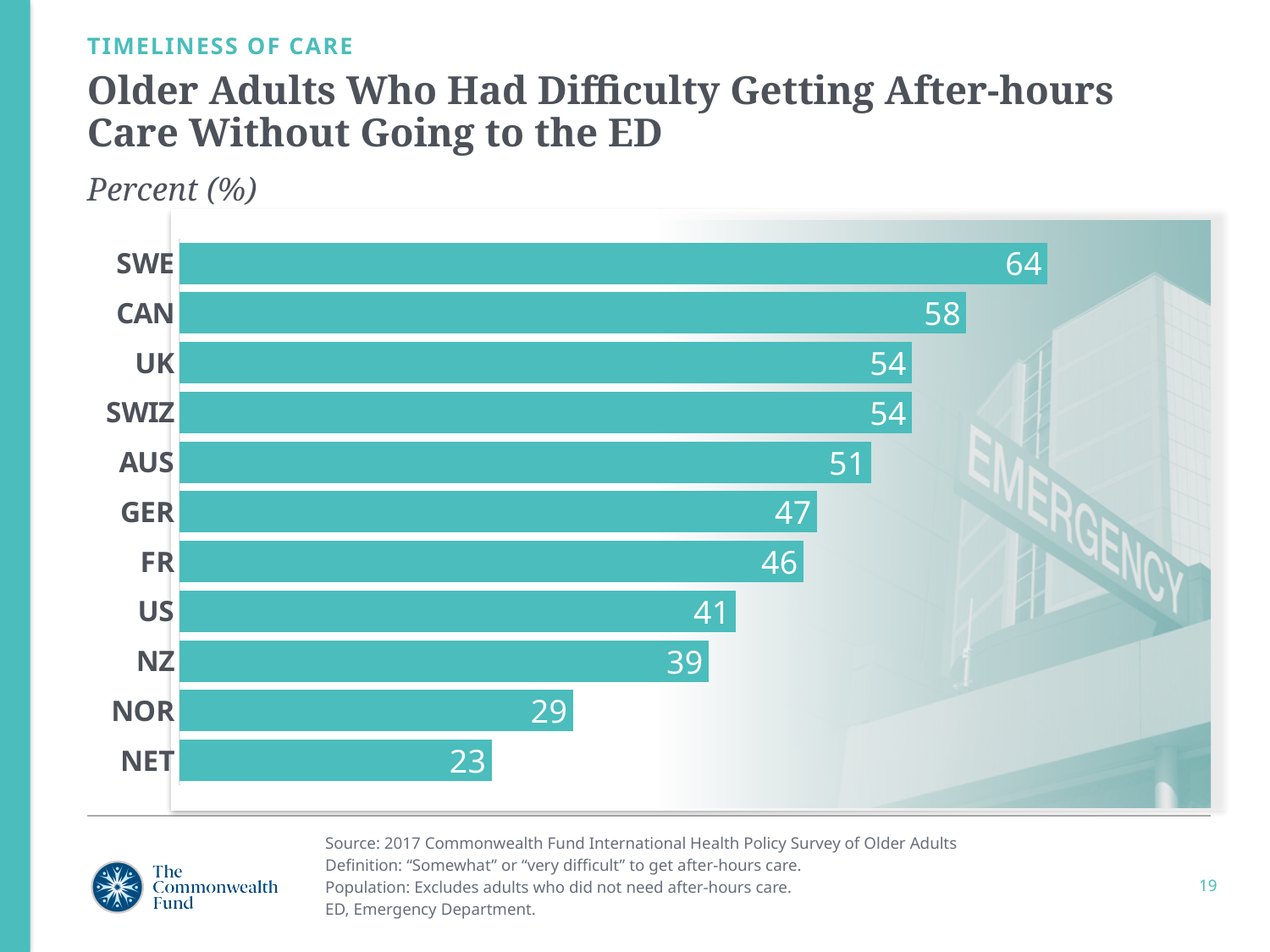
What is the value for NOR? 29 Which country has the highest value? SWE How many countries are shown in the chart? 11 Which two countries share the same value of 54? UK and SWIZ Which country has the lowest value? NET What is the value for FR? 46 What unit is the chart measured in, according to the subtitle? Percent (%) What kind of chart is shown on the slide? Bar chart What is the difference between the values for SWE and NET? 41 What is the difference between the values for CAN and US? 17 What is the value for SWE? 64 Which is larger, the value for GER or the value for NZ? GER